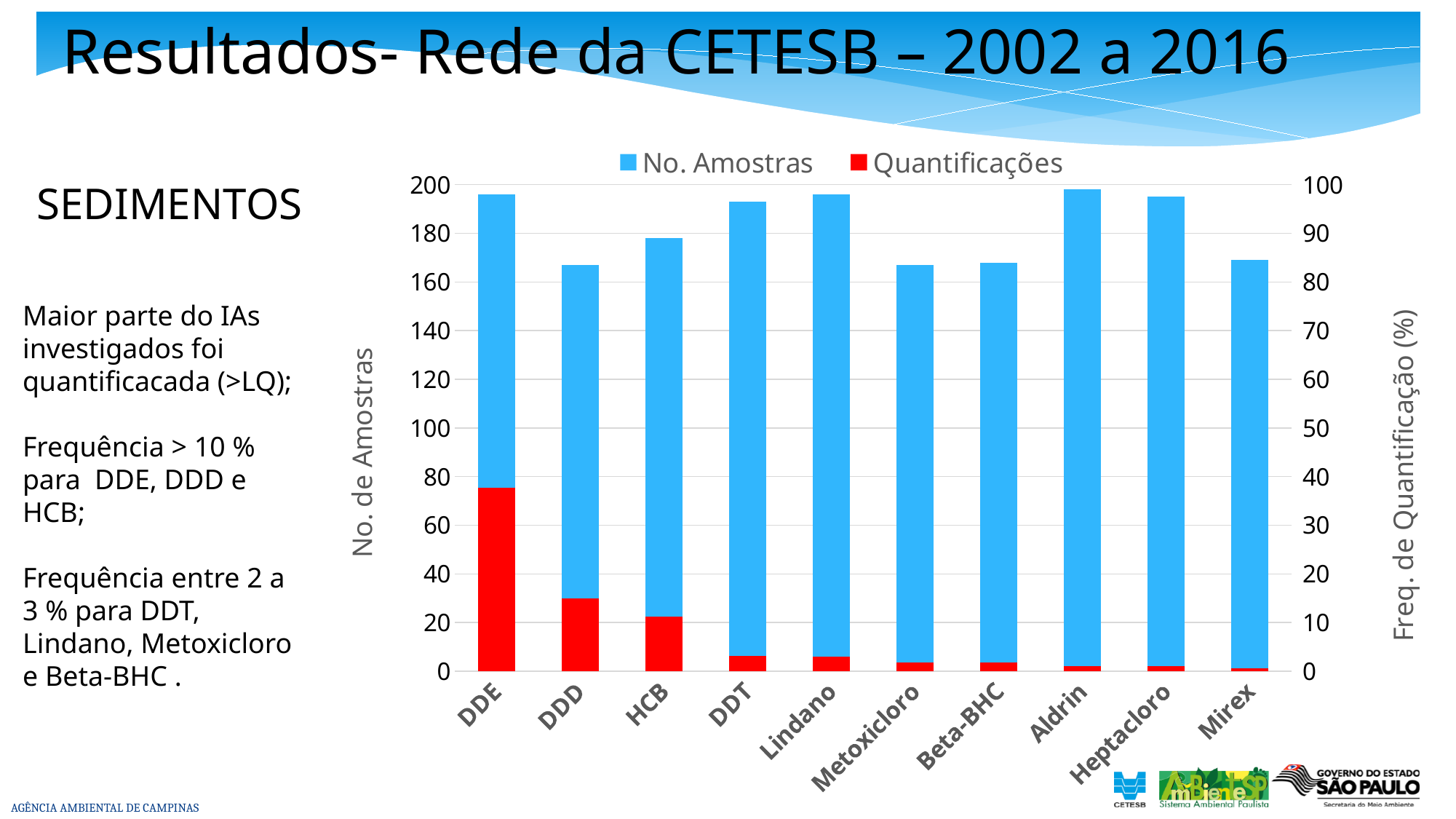
Is the Quantificações value for DDE greater or less than 60 on the left axis? greater Which category has the highest Quantificações value? DDE Which has a larger Quantificações value, DDE or DDD? DDE Which has a larger No. Amostras value, HCB or DDD? HCB Is the Quantificações value for DDD greater or less than 40 on the left axis? less What is the title of the right-hand vertical axis of the chart? Freq. de Quantificação (%) Is the No. Amostras value for DDD greater or less than 180? less What kind of chart is shown on the slide? bar chart How many categories are shown on the x axis of the chart? 10 What colour represents the Quantificações series in the chart? red How many series does the chart legend list? 2